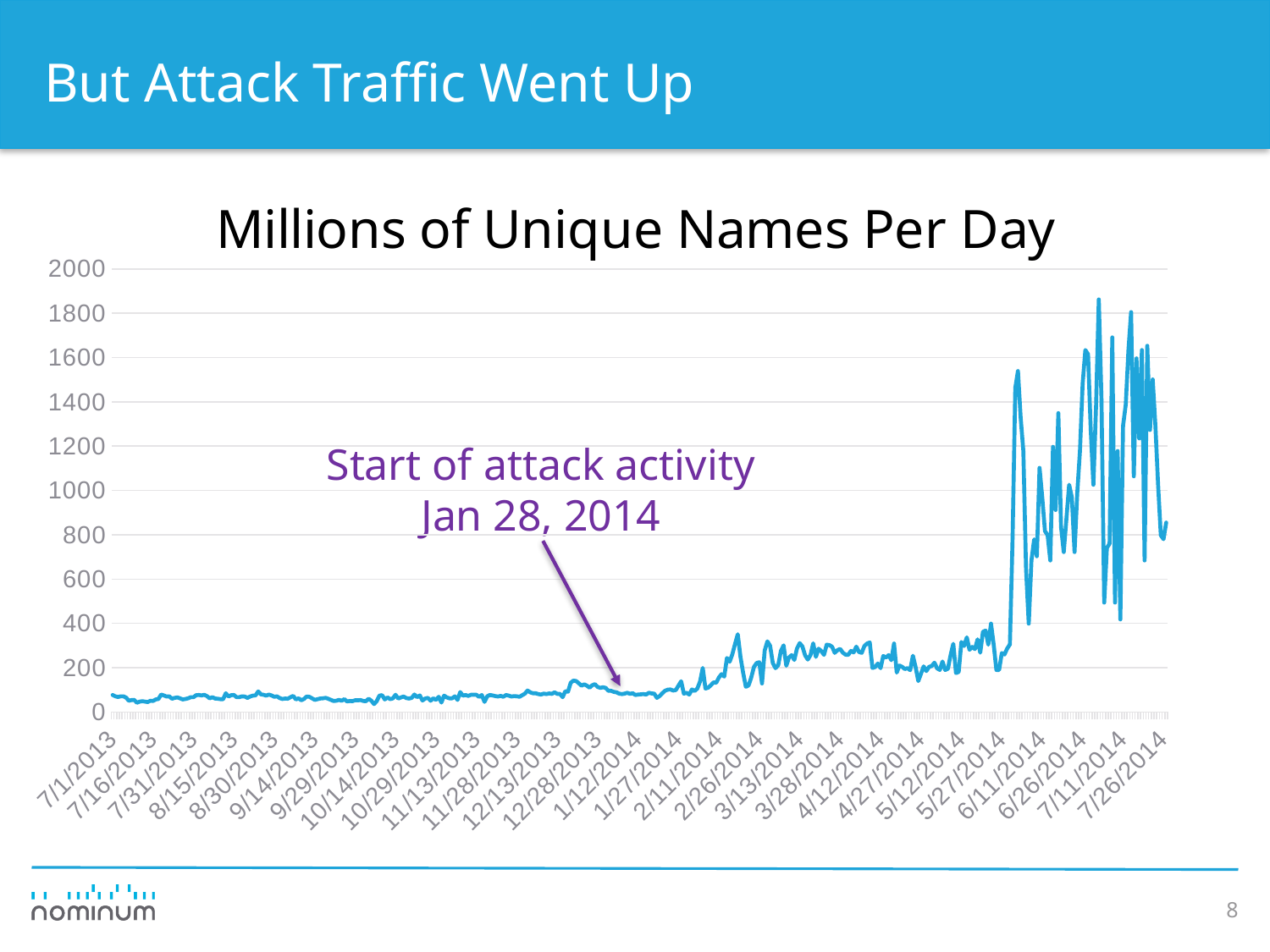
Is the value on 3/28/2014 greater or less than 400? less Is the value on 7/1/2013 greater or less than 200? less Is the peak value of the line greater or less than 1600? greater What is the last date label on the x axis? 7/26/2014 What is the title of the chart? Millions of Unique Names Per Day What kind of chart is shown on the slide? line chart What is the highest value shown on the y axis? 2000 According to the annotation on the chart, on what date did attack activity start? Jan 28, 2014 Which is larger, the value on 7/1/2013 or the value on 7/26/2014? 7/26/2014 What is the first date label on the x axis? 7/1/2013 Overall, do the values rise or fall from left to right along the x axis? rise